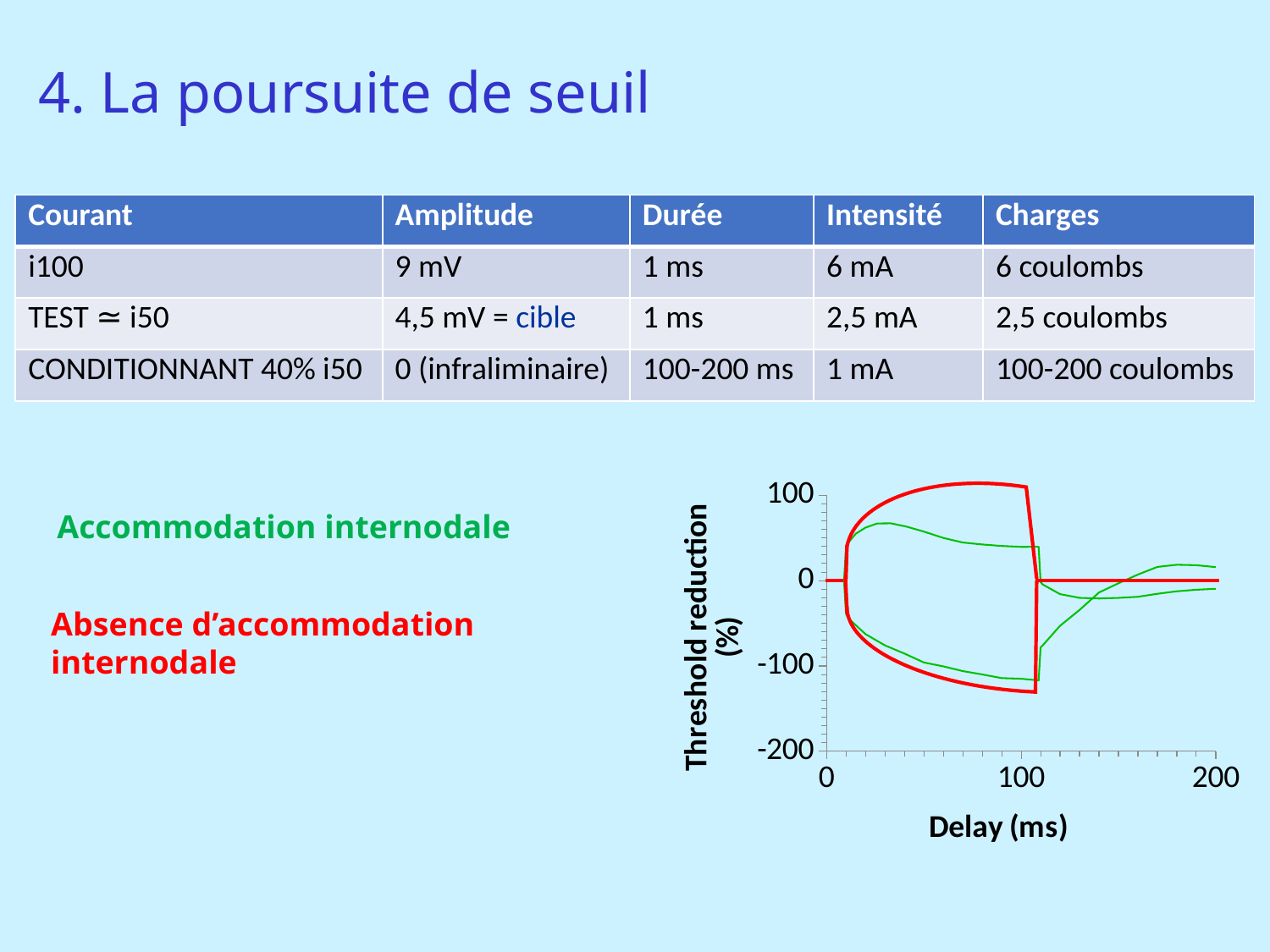
Is the value of the upper red curve at a delay of 50 ms greater or less than 0? greater Is the value of the upper green curve at a delay of 50 ms greater or less than 0? greater What is the title of the y axis of the chart? Threshold reduction (%) What kind of chart is shown on the slide? line chart Is the value of the upper green curve at a delay of 50 ms greater or less than 100? less Between a delay of 0 ms and 100 ms, does the lower red curve rise or fall? fall What is the highest value shown on the y axis of the chart? 100 What is the lowest value shown on the y axis of the chart? -200 Between a delay of 0 ms and 100 ms, does the upper red curve rise or fall? rise What is the highest value shown on the x axis of the chart? 200 What is the title of the x axis of the chart? Delay (ms)